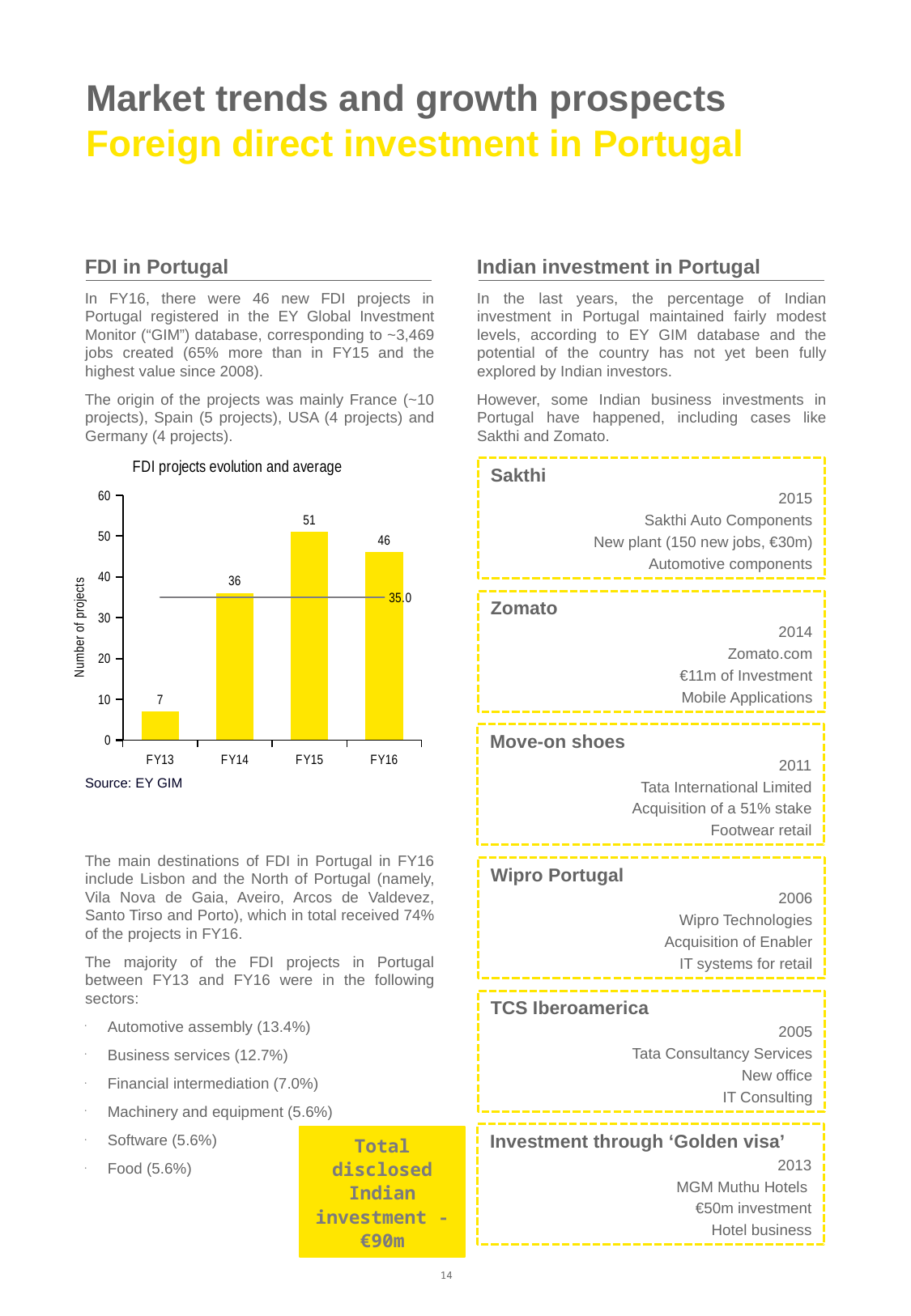
What is the number of FDI projects in FY15? 51 What is the number of FDI projects in FY13? 7 What is the number of FDI projects in FY16? 46 What is the difference in the number of FDI projects between FY15 and FY16? 5 Which year has more FDI projects, FY14 or FY16? FY16 Which year has the lowest number of FDI projects? FY13 What type of chart is used to show the FDI projects evolution? Bar chart What is the difference in the number of FDI projects between FY14 and FY13? 29 Which year has the highest number of FDI projects? FY15 How many years are shown on the x axis of the chart? 4 What is the average value shown by the horizontal line on the chart? 35.0 What is the title of the chart? FDI projects evolution and average